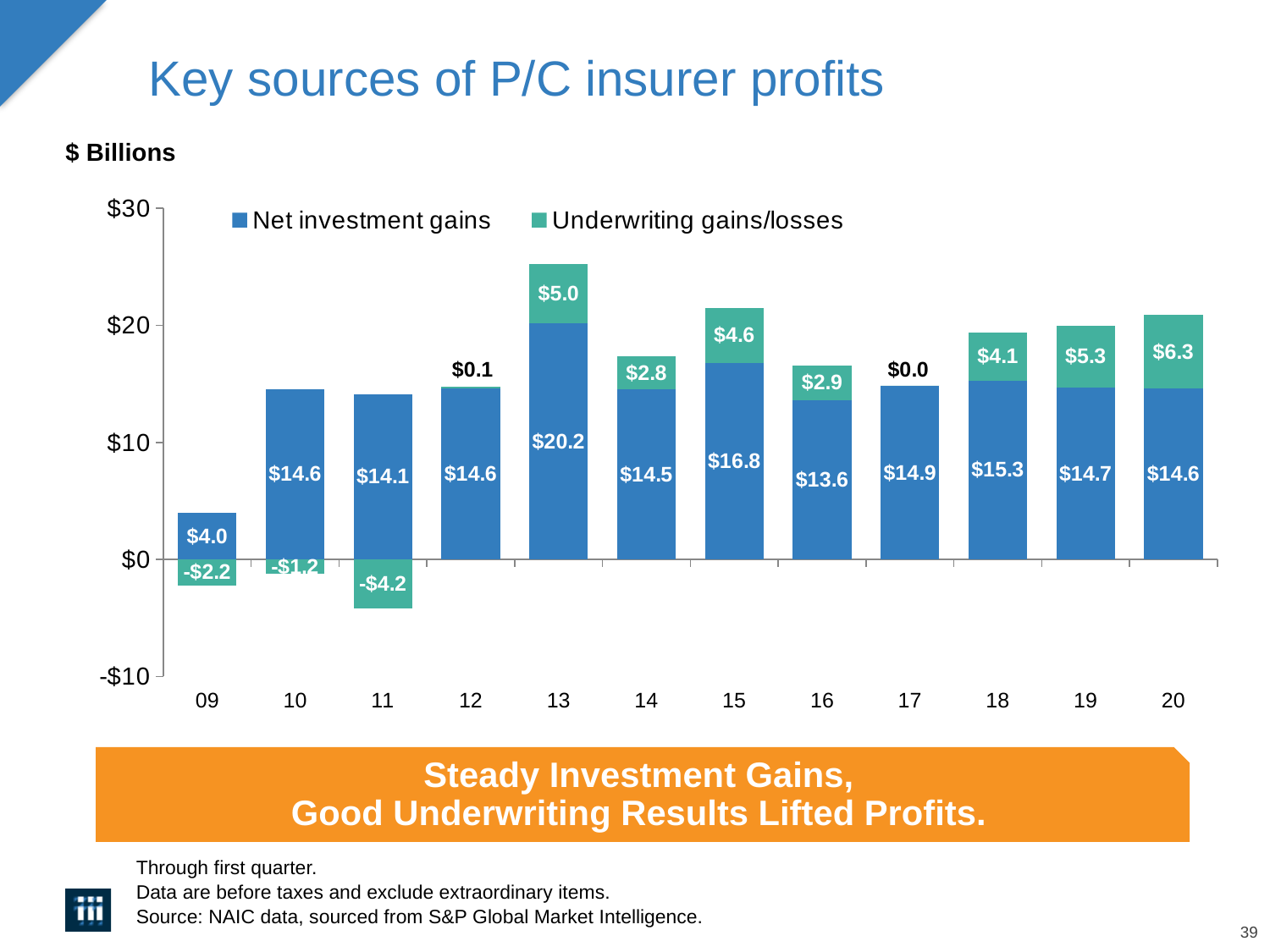
What is the value of Underwriting gains/losses for 11? -$4.2 Which is larger, Underwriting gains/losses in 19 or in 18? 19 What is the total of the stacked bar for 15? $21.4 What is the value of Underwriting gains/losses for 20? $6.3 What kind of chart is shown on the slide? Stacked bar chart Which year has the highest Net investment gains? 13 How many years are shown on the x axis? 12 What is the value of Net investment gains for 13? $20.2 What is the difference between Net investment gains in 13 and in 16? $6.6 Which year has the lowest Underwriting gains/losses? 11 How many series does the legend list? 2 Which year has the lowest Net investment gains? 09